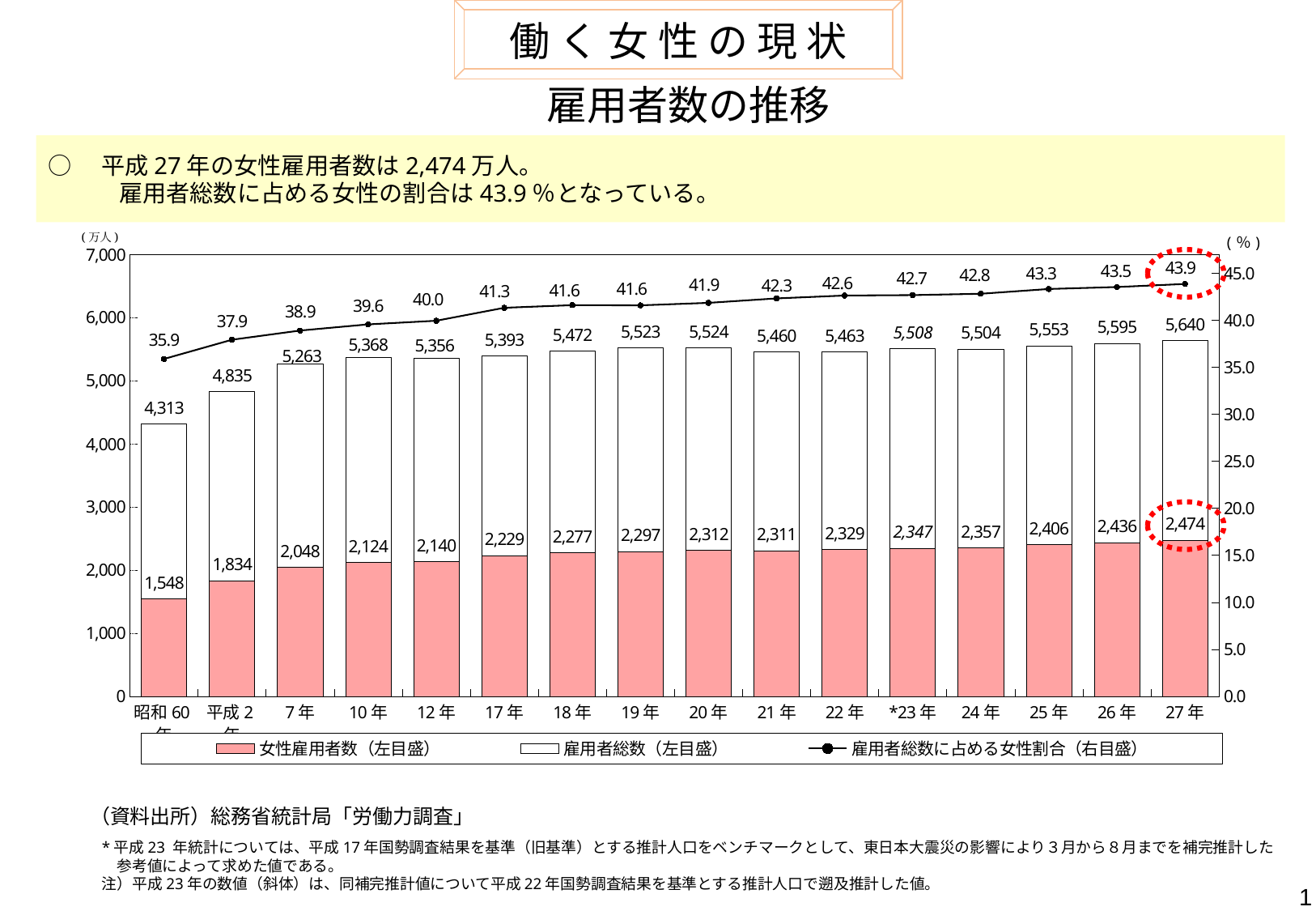
What is the share of women among all employees (雇用者総数に占める女性割合) in 昭和60年? 35.9 What is the total number of employees (雇用者総数) in 平成27年? 5,640 What is the number of female employees in 平成2年? 1,834 How many series does the legend list? 3 What is the difference between the total number of employees and the number of female employees in 27年? 3,166 What is the number of female employees (女性雇用者数) in 平成27年? 2,474 How many years (categories) are shown on the x axis? 16 By how much did the number of female employees increase from 26年 to 27年? 38 Which year has the highest total number of employees? 27年 Which year has the lowest number of female employees? 昭和60年 Which is larger, the total number of employees in 19年 or in 21年? 19年 Does the share of women among all employees rise or fall from 昭和60年 to 27年? rise